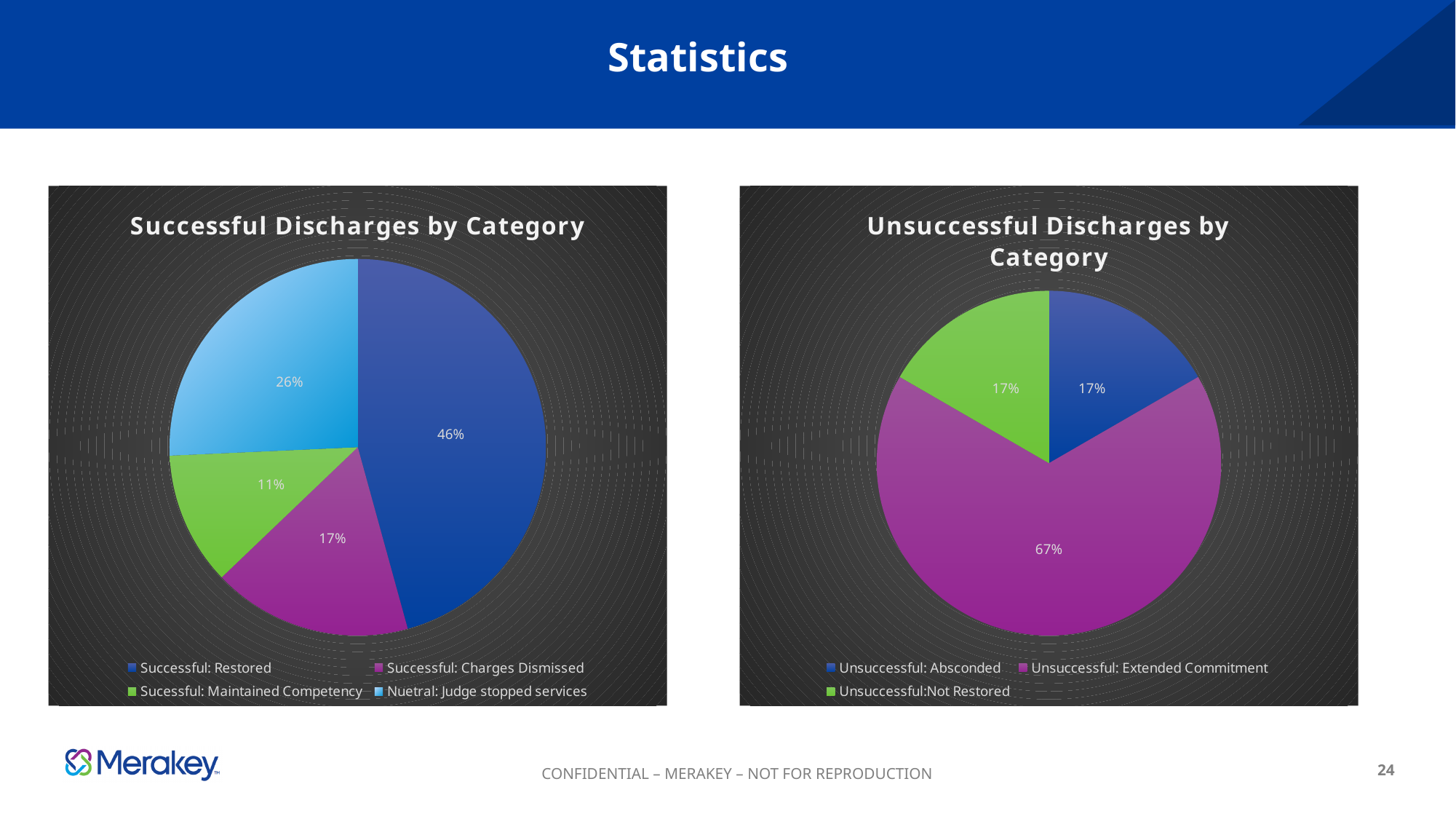
In the 'Successful Discharges by Category' chart, which category has the largest slice? Successful: Restored In the 'Successful Discharges by Category' chart, how many categories are shown? 4 In the 'Unsuccessful Discharges by Category' chart, what share does 'Unsuccessful: Extended Commitment' have? 67% In the 'Successful Discharges by Category' chart, which category has the smallest slice? Sucessful: Maintained Competency In the 'Successful Discharges by Category' chart, what share does 'Sucessful: Maintained Competency' have? 11% In the 'Successful Discharges by Category' chart, what is the difference between the 'Successful: Restored' and 'Successful: Charges Dismissed' shares? 29% What type of chart is the 'Unsuccessful Discharges by Category' chart? Pie chart In the 'Unsuccessful Discharges by Category' chart, what share does 'Unsuccessful: Absconded' have? 17% In the 'Successful Discharges by Category' chart, what share does 'Successful: Restored' have? 46% In the 'Successful Discharges by Category' chart, what share does 'Nuetral: Judge stopped services' have? 26% In the 'Unsuccessful Discharges by Category' chart, which category has the largest slice? Unsuccessful: Extended Commitment In the 'Unsuccessful Discharges by Category' chart, how many categories are shown? 3